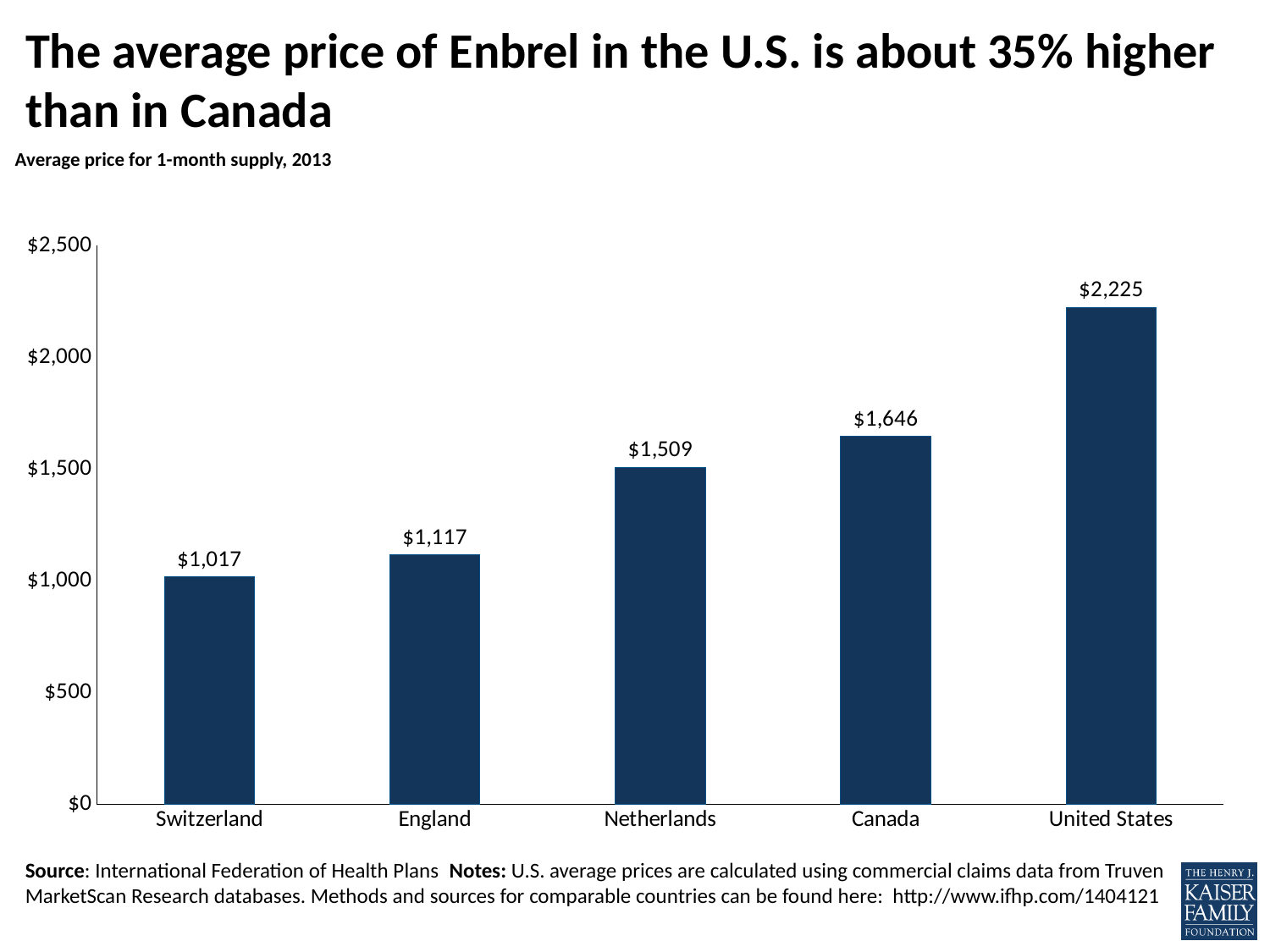
What is the difference between the average price of Enbrel in England and in Switzerland? $100 What is the difference between the average price of Enbrel in the United States and in Canada? $579 Which has a higher average price of Enbrel, the Netherlands or England? Netherlands Which country has the lowest average price of Enbrel? Switzerland What is the average price of Enbrel for a 1-month supply in Canada? $1,646 Is the average price of Enbrel in the United States greater or less than $2,000? greater Do the average prices rise or fall moving from left to right across the countries? Rise How many countries are shown in the chart? 5 What kind of chart is shown on the slide? Bar chart What is the average price of Enbrel for a 1-month supply in the Netherlands? $1,509 Which country has the highest average price of Enbrel? United States What is the average price of Enbrel for a 1-month supply in Switzerland? $1,017